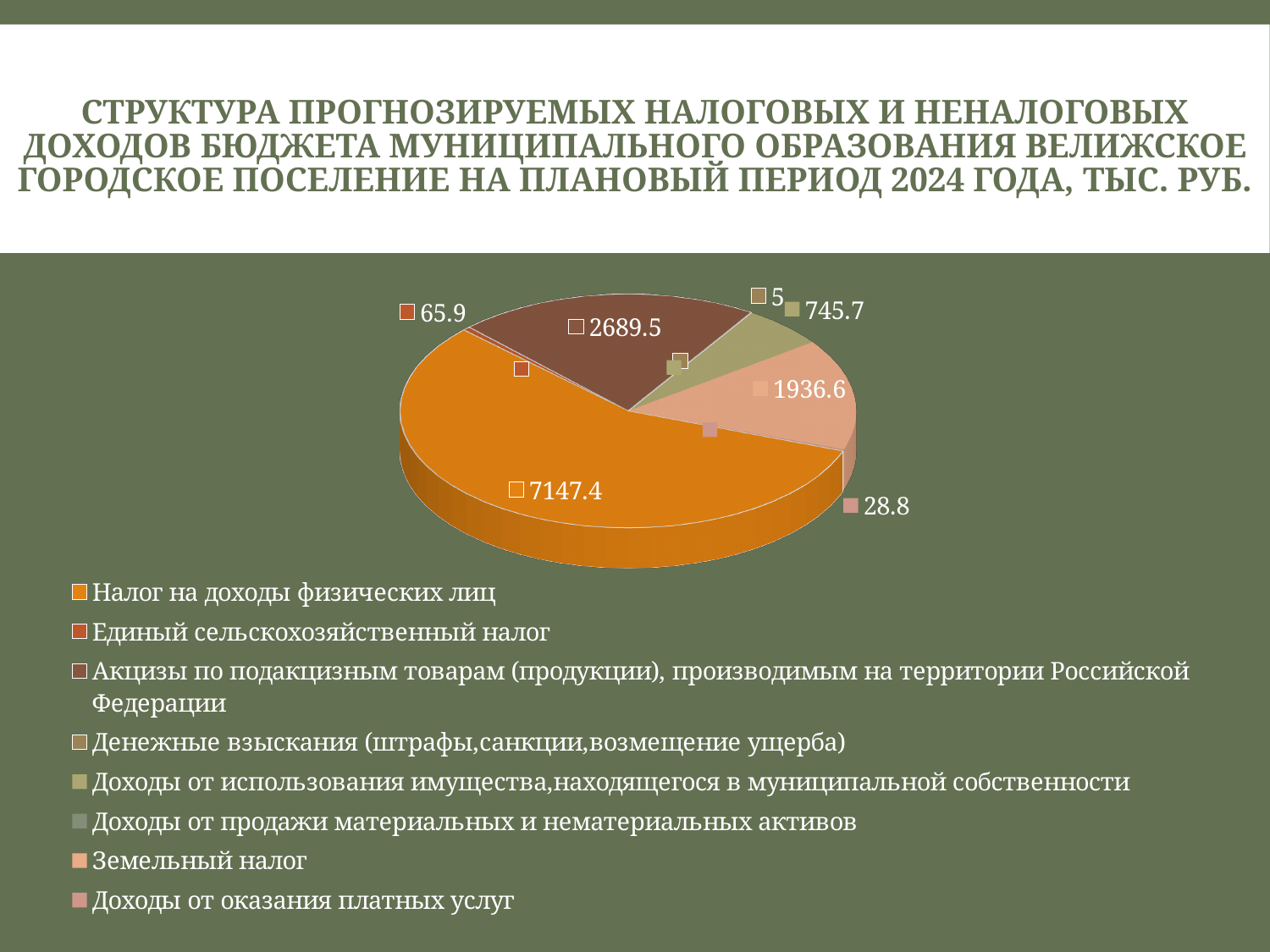
Which is larger: Земельный налог or Акцизы по подакцизным товарам? Акцизы по подакцизным товарам What is the value for Доходы от использования имущества, находящегося в муниципальной собственности? 745.7 What is the difference between Налог на доходы физических лиц and Акцизы по подакцизным товарам? 4457.9 In what units are the values on the chart given, according to the title? тыс. руб. What is the value for Единый сельскохозяйственный налог? 65.9 Which labelled slice has the smallest value? Денежные взыскания (штрафы,санкции,возмещение ущерба) How many categories does the legend of the pie chart list? 8 What is the value for Земельный налог? 1936.6 What is the value for Налог на доходы физических лиц? 7147.4 What kind of chart is shown on the slide? pie chart Which category has the largest slice of the pie? Налог на доходы физических лиц What is the value for Акцизы по подакцизным товарам (продукции), производимым на территории Российской Федерации? 2689.5